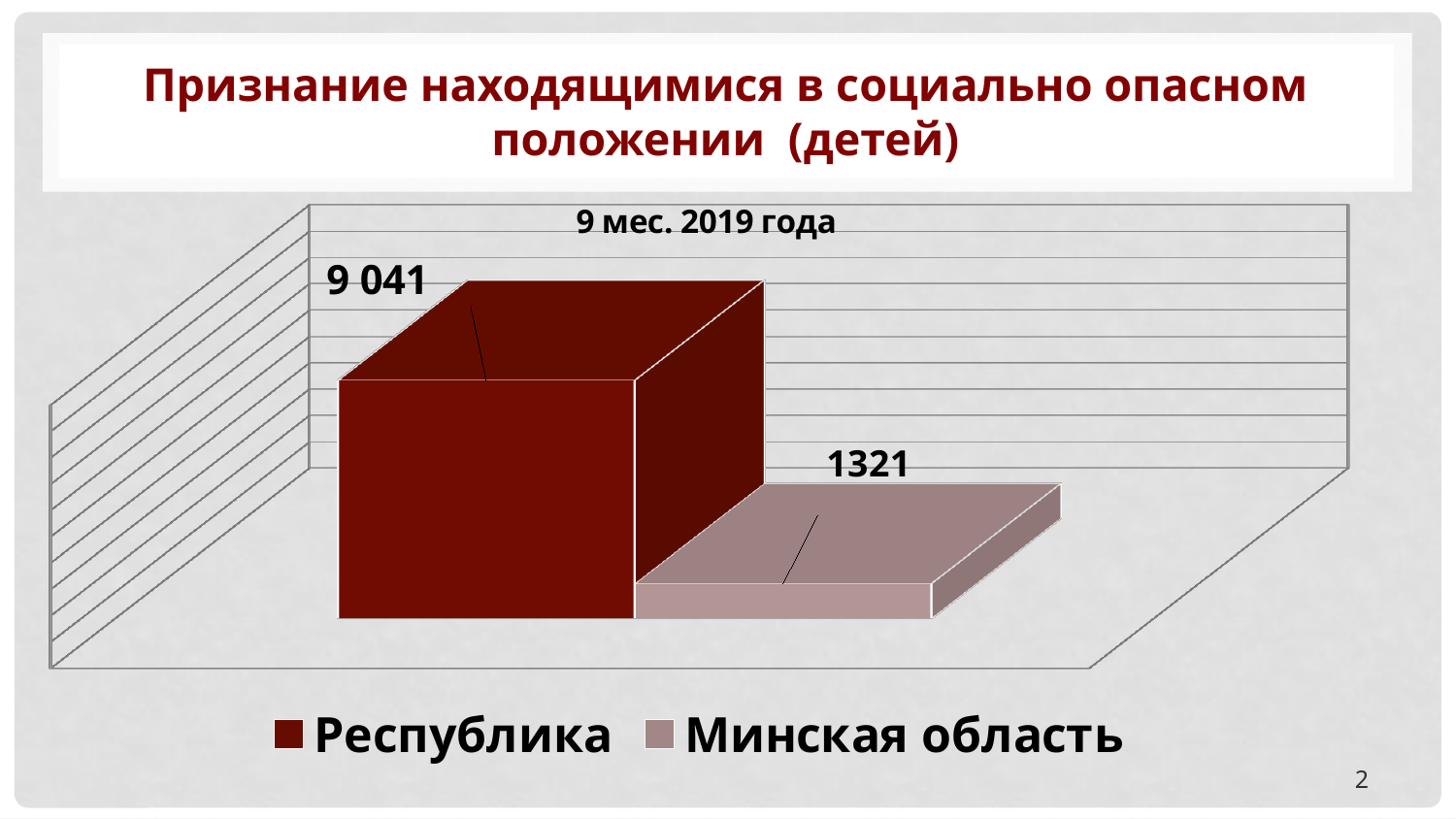
Which series is shown in dark red in the chart? Республика How many series does the legend list? 2 What is the title of the chart? 9 мес. 2019 года What kind of chart is shown on the slide? Bar chart How many bars are plotted in the chart? 2 Which series has the highest value in the chart? Республика What is the value for Минская область in the chart? 1321 Which is larger, the value for Республика or the value for Минская область? Республика What is the value for Республика in the chart? 9 041 Which series has the lowest value in the chart? Минская область What is the difference between the value for Республика and the value for Минская область? 7720